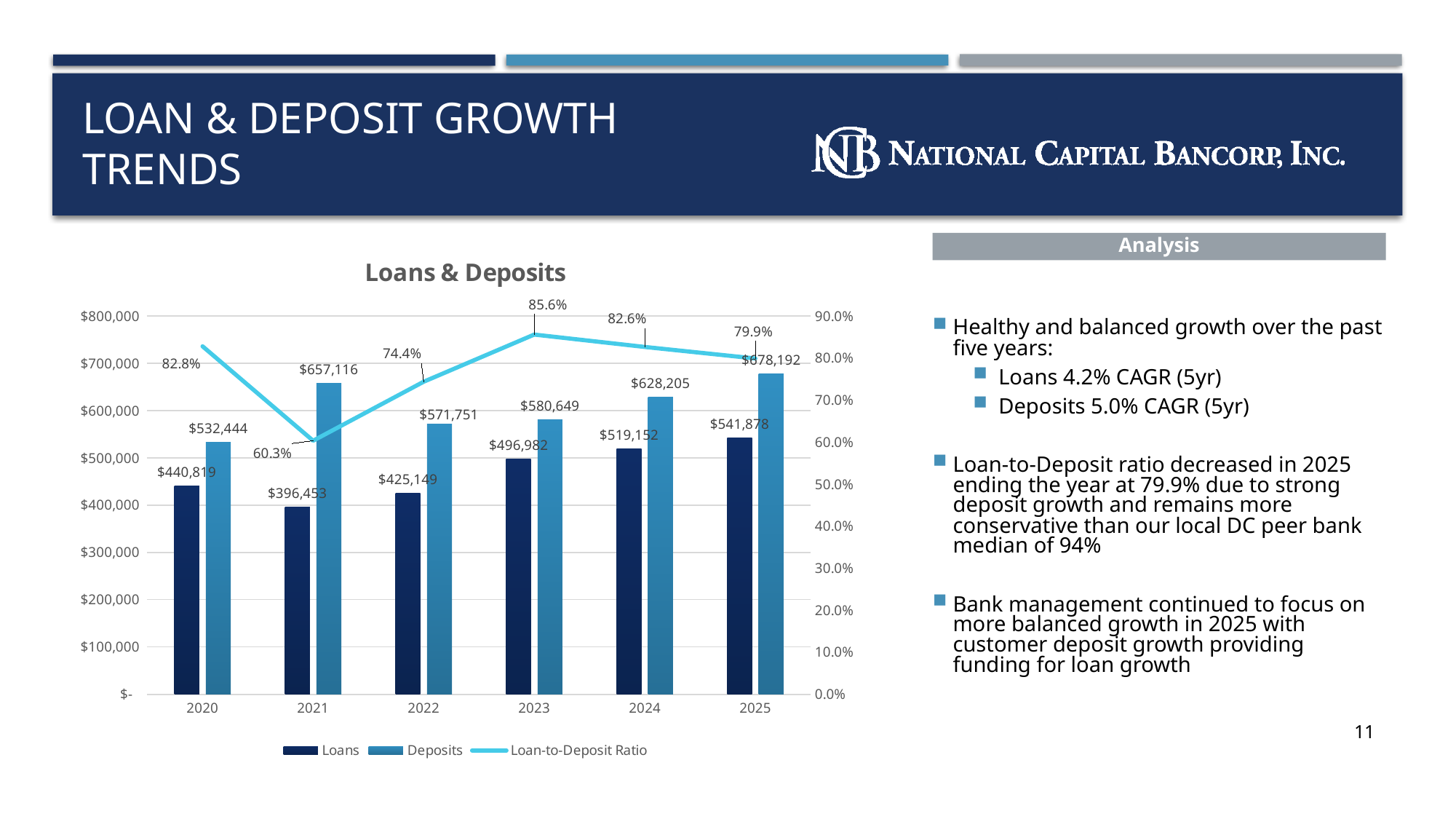
In which year is the Loan-to-Deposit Ratio highest? 2023 What is the difference between Deposits and Loans in 2025? $136,314 Is the value for Loans in 2024 greater or less than $500,000? greater Do Loans rise or fall from 2021 to 2025? rise What is the Loan-to-Deposit Ratio in 2025? 79.9% In which year are Loans lowest? 2021 What is the value of Loans in 2023? $496,982 In which year are Deposits highest? 2025 What is the value of Deposits in 2021? $657,116 How many series does the legend list? 3 Which year has larger Deposits, 2021 or 2022? 2021 How many years are shown on the x axis? 6